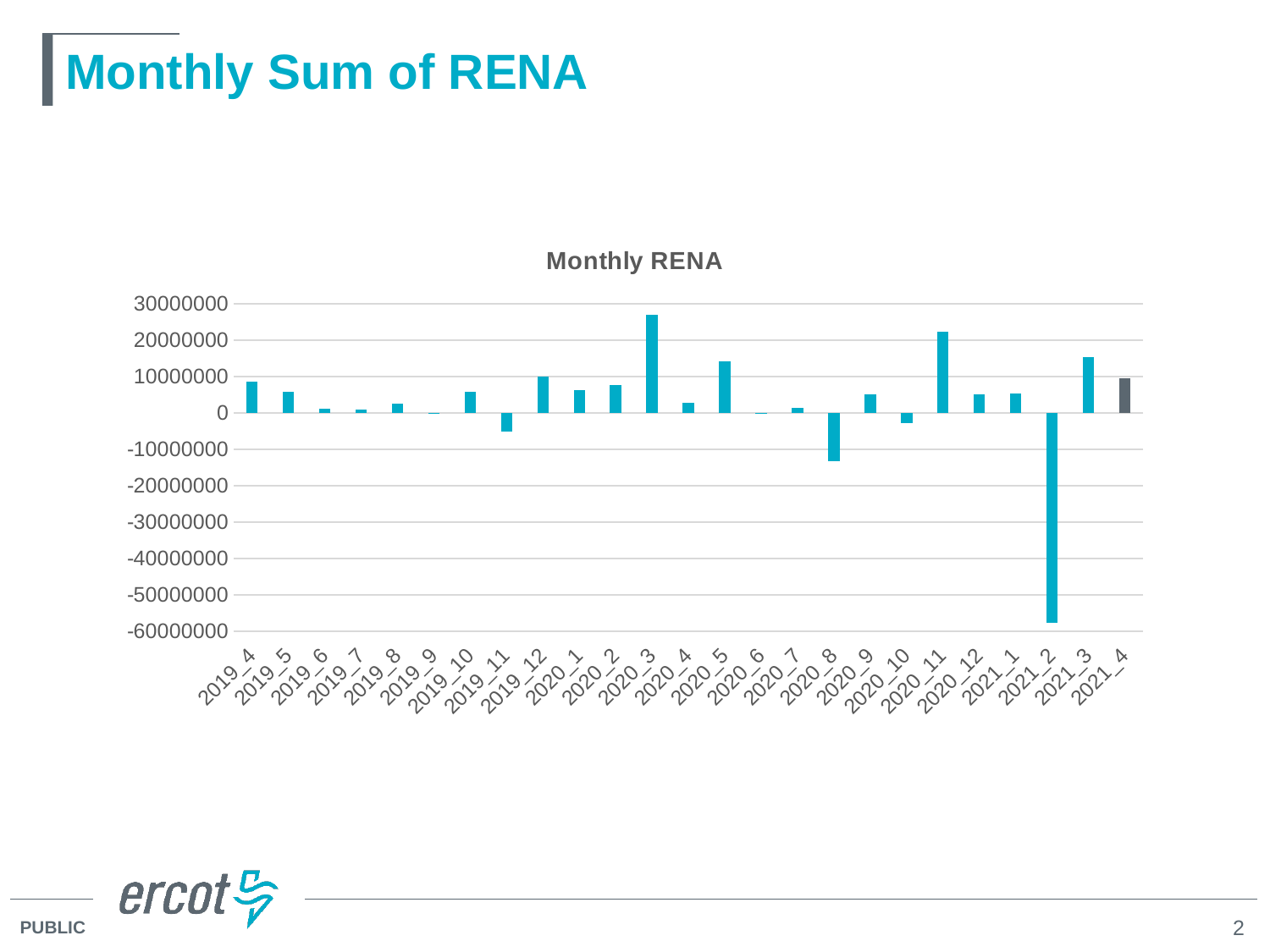
Is the value for 2020_3 greater or less than 20000000? greater Which month has the highest value? 2020_3 What kind of chart is shown on the slide? bar chart Which bar is drawn in a different colour (dark grey) from the rest? 2021_4 Is the value for 2019_4 greater or less than 10000000? less Which month has the lowest value? 2021_2 What is the title of the chart? Monthly RENA Is the value for 2021_2 greater or less than -50000000? less Which is larger, the value for 2020_3 or the value for 2020_11? 2020_3 How many monthly categories are plotted on the x axis? 25